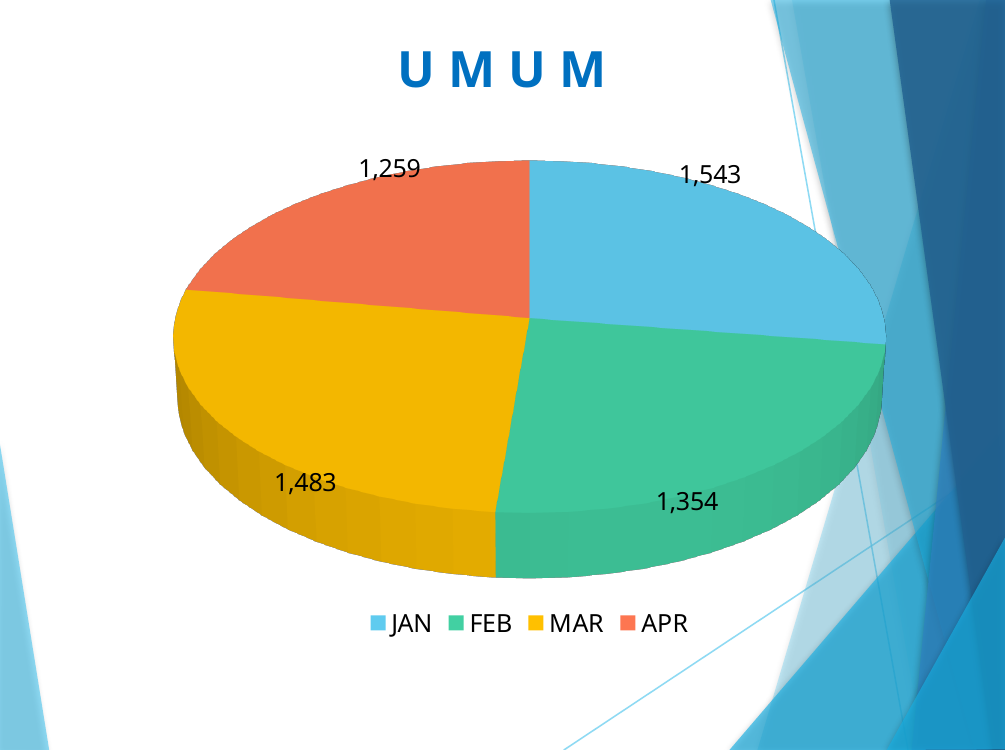
What is the value for APR? 1,259 What is the value for MAR? 1,483 Which month has the smallest slice? APR What is the title of the chart? UMUM What kind of chart is shown on the slide? Pie chart What is the difference between the values for MAR and FEB? 129 Which is larger, the value for FEB or the value for MAR? MAR What share of the total does the JAN slice represent? 27.4% How many slices does the pie chart have? 4 What is the value for JAN? 1,543 What is the difference between the values for JAN and APR? 284 Which month has the largest slice? JAN